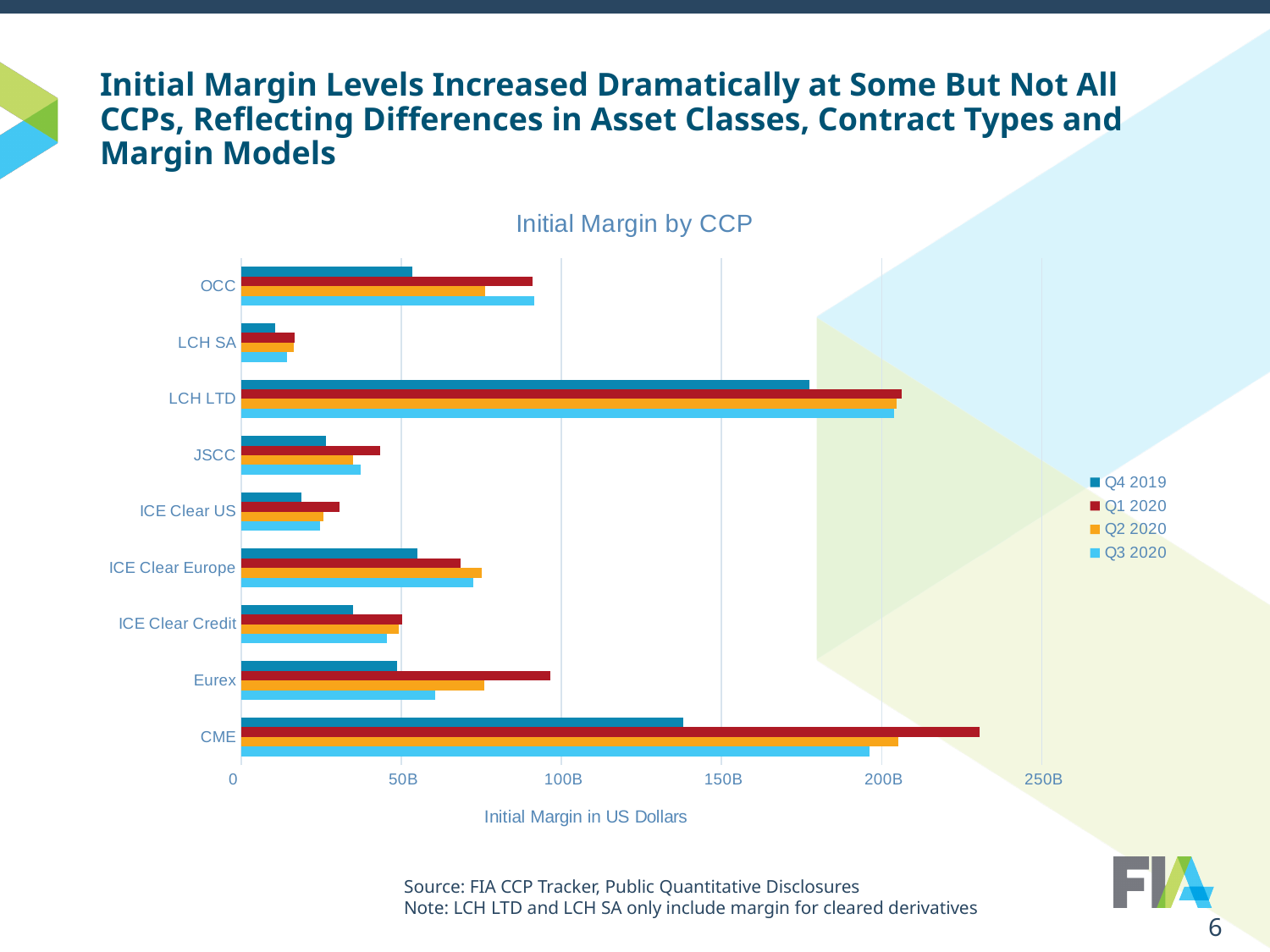
Which CCP has the lowest Q4 2019 initial margin? LCH SA Is the Q1 2020 value for CME greater or less than 200B? greater Is the Q4 2019 value for LCH LTD greater or less than 150B? greater Is the Q1 2020 value for OCC greater or less than 100B? less Which is larger for Q4 2019: OCC or ICE Clear Credit? OCC Which is larger for Eurex: the Q1 2020 value or the Q3 2020 value? Q1 2020 How many CCPs are listed on the vertical axis of the chart? 9 Which CCP has the highest Q1 2020 initial margin? CME What is the title of the chart? Initial Margin by CCP How many series does the legend list? 4 What kind of chart is shown on the slide? bar chart Which CCP has the highest Q4 2019 initial margin? LCH LTD